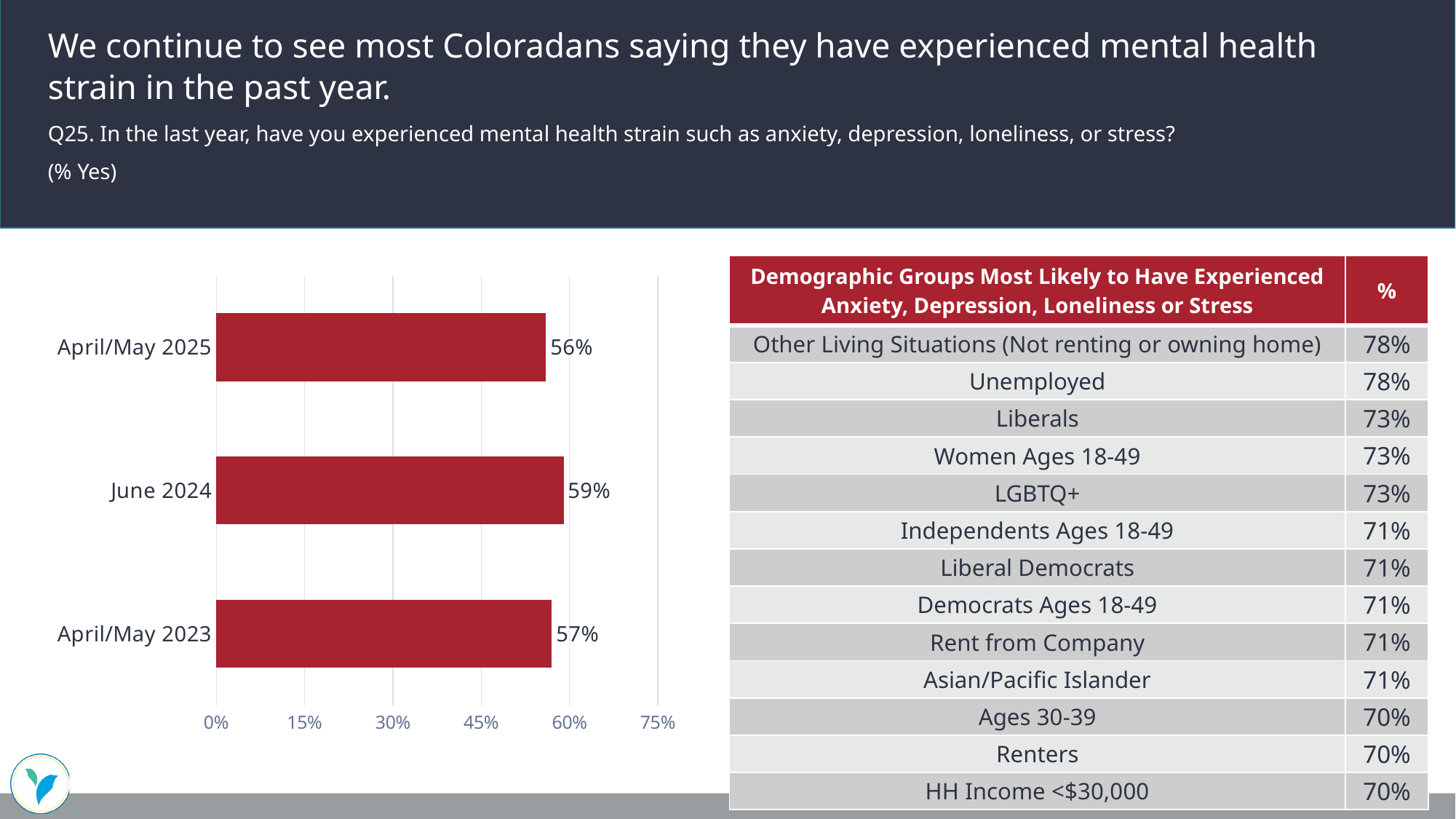
What kind of chart is used to show the survey results by period? Bar chart Which is larger, the value for April/May 2023 or the value for April/May 2025? April/May 2023 What is the value shown for June 2024? 59% What is the highest value shown on the chart's horizontal axis? 75% Which survey period has the lowest percentage saying yes? April/May 2025 Is the value for June 2024 greater or less than 45%? greater What colour are the bars in the chart? Red What percentage of Coloradans said they experienced mental health strain in April/May 2025? 56% How many survey periods are plotted in the bar chart? 3 Which survey period has the highest percentage saying yes? June 2024 What is the value shown for April/May 2023? 57% What is the difference between the June 2024 value and the April/May 2025 value? 3 percentage points